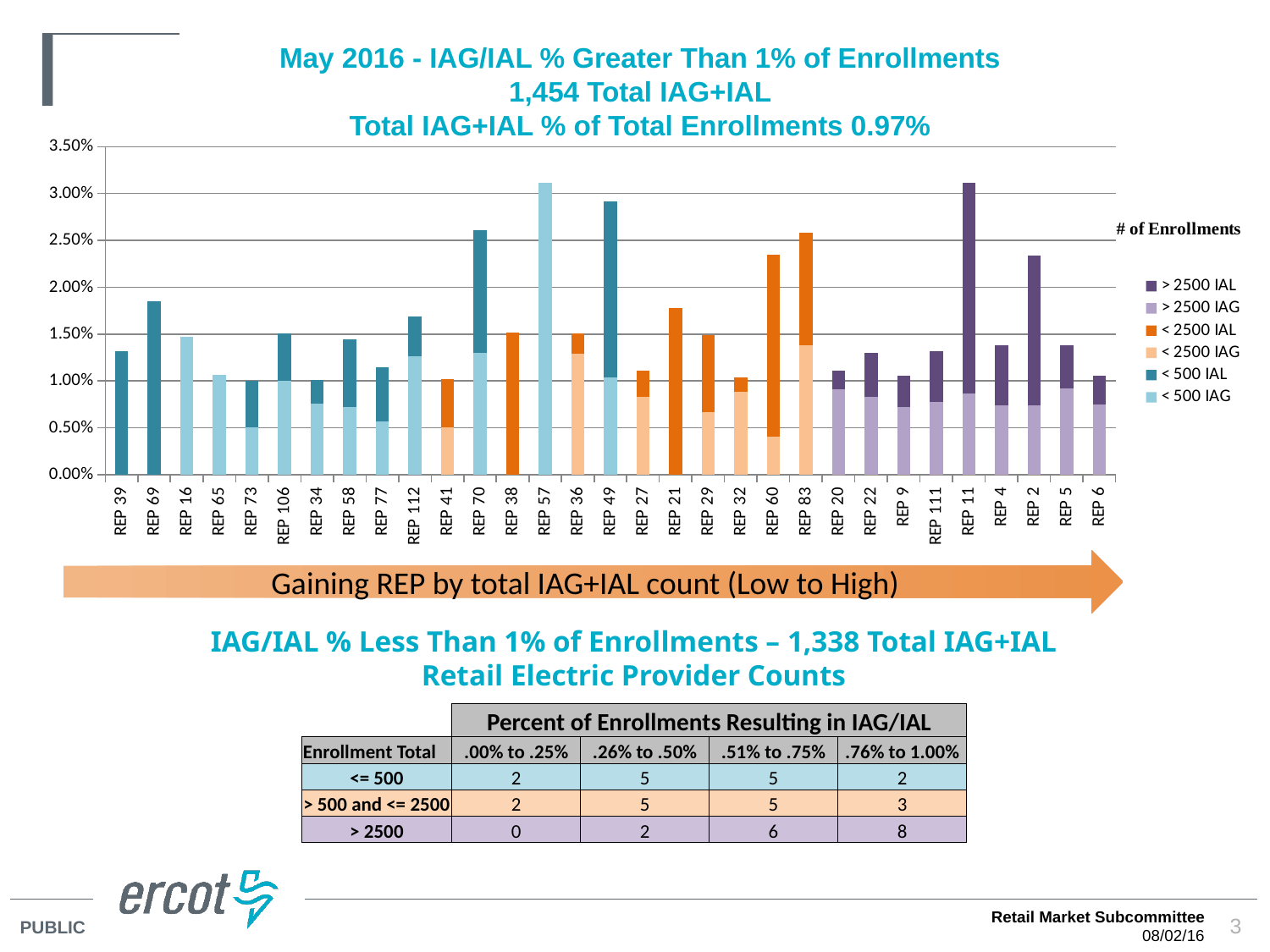
Which has the larger total value, REP 49 or REP 36? REP 49 What is the title of the chart's legend? # of Enrollments What is the first line of the chart title? May 2016 - IAG/IAL % Greater Than 1% of Enrollments How many series does the chart legend list? 6 How many REP categories are shown on the x axis of the chart? 31 Is the value for REP 49 greater or less than 2.50%? greater Is the value for REP 41 greater or less than 1.50%? less Is the value for REP 60 greater or less than 2.00%? greater What kind of chart is shown on the slide? Stacked bar chart Which has the larger total value, REP 69 or REP 16? REP 69